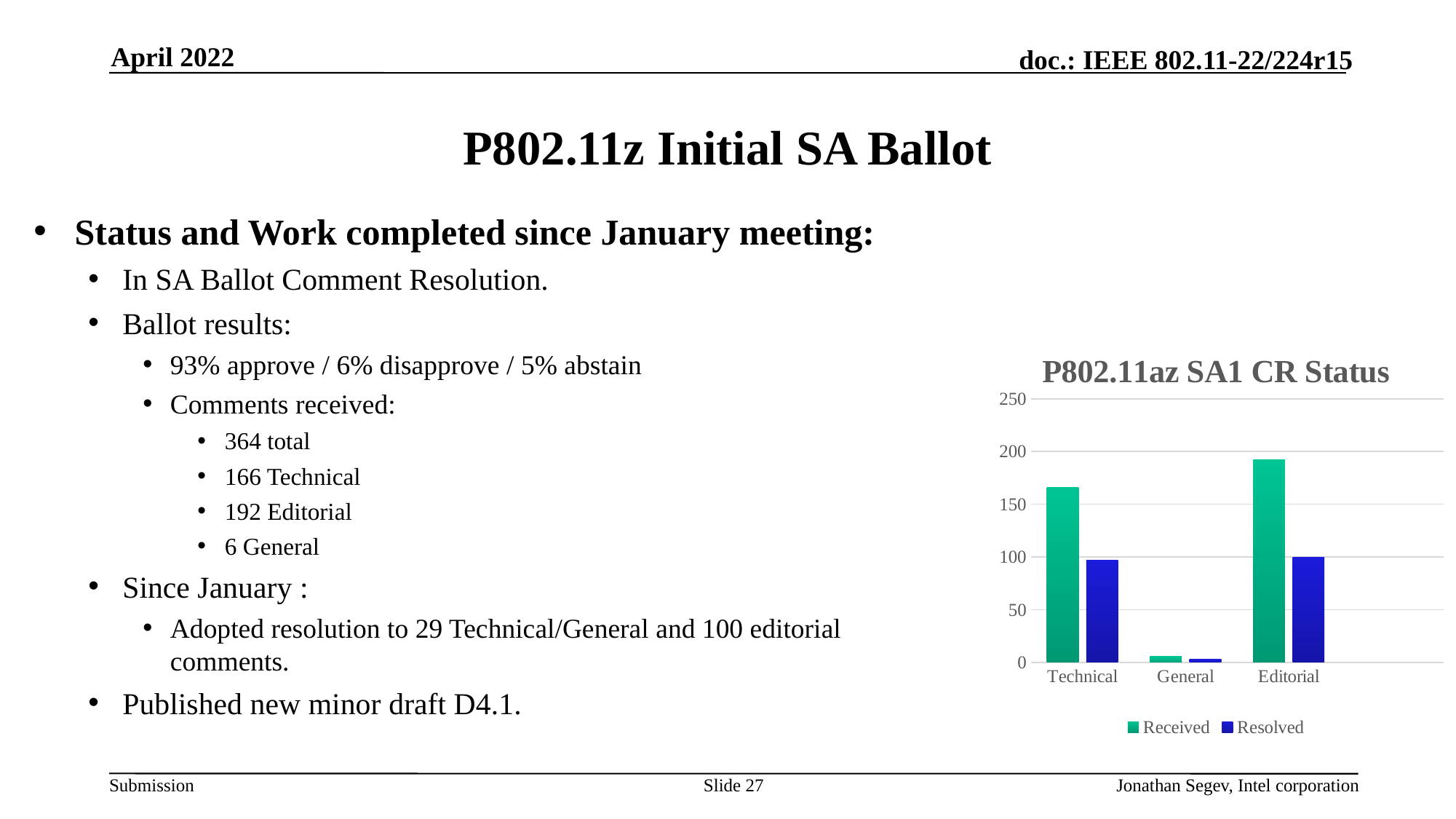
Which category has the lowest Resolved value? General Is the Received value for Editorial greater or less than 200? less Which category has the lowest Received value? General How many series does the chart legend list? 2 Is the Received value for General greater or less than 50? less What kind of chart is shown on the slide? bar chart What is the title of the chart? P802.11az SA1 CR Status For Editorial, which is larger, the Received value or the Resolved value? Received Is the Received value for Technical greater or less than 150? greater How many categories are shown on the x axis of the chart? 3 Which category has the highest Received value? Editorial